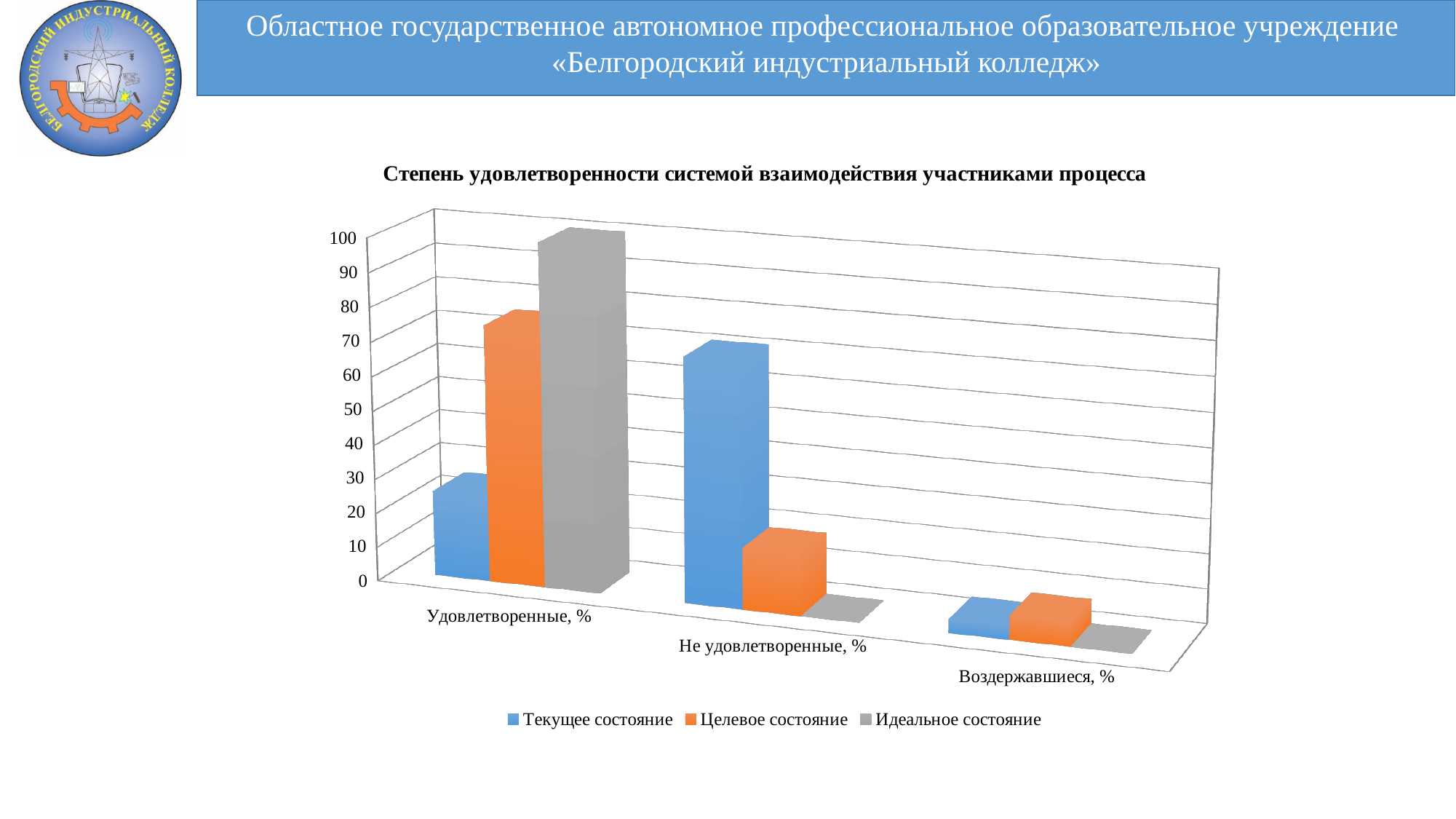
For the category Удовлетворенные, %, which series has the larger value: Текущее состояние or Целевое состояние? Целевое состояние Which category has the highest value for the Текущее состояние series? Не удовлетворенные, % Which category has the highest value for the Идеальное состояние series? Удовлетворенные, % What is the title of the chart? Степень удовлетворенности системой взаимодействия участниками процесса What kind of chart is shown on the slide? bar chart Which category has the lowest value for the Текущее состояние series? Воздержавшиеся, % How many categories are shown on the x axis? 3 Is the value for Текущее состояние in the category Удовлетворенные, % greater or less than 50? less Which series is shown in orange in the legend? Целевое состояние How many series does the legend list? 3 For the category Не удовлетворенные, %, which series has the larger value: Текущее состояние or Целевое состояние? Текущее состояние Is the value for Идеальное состояние in the category Удовлетворенные, % greater or less than 80? greater